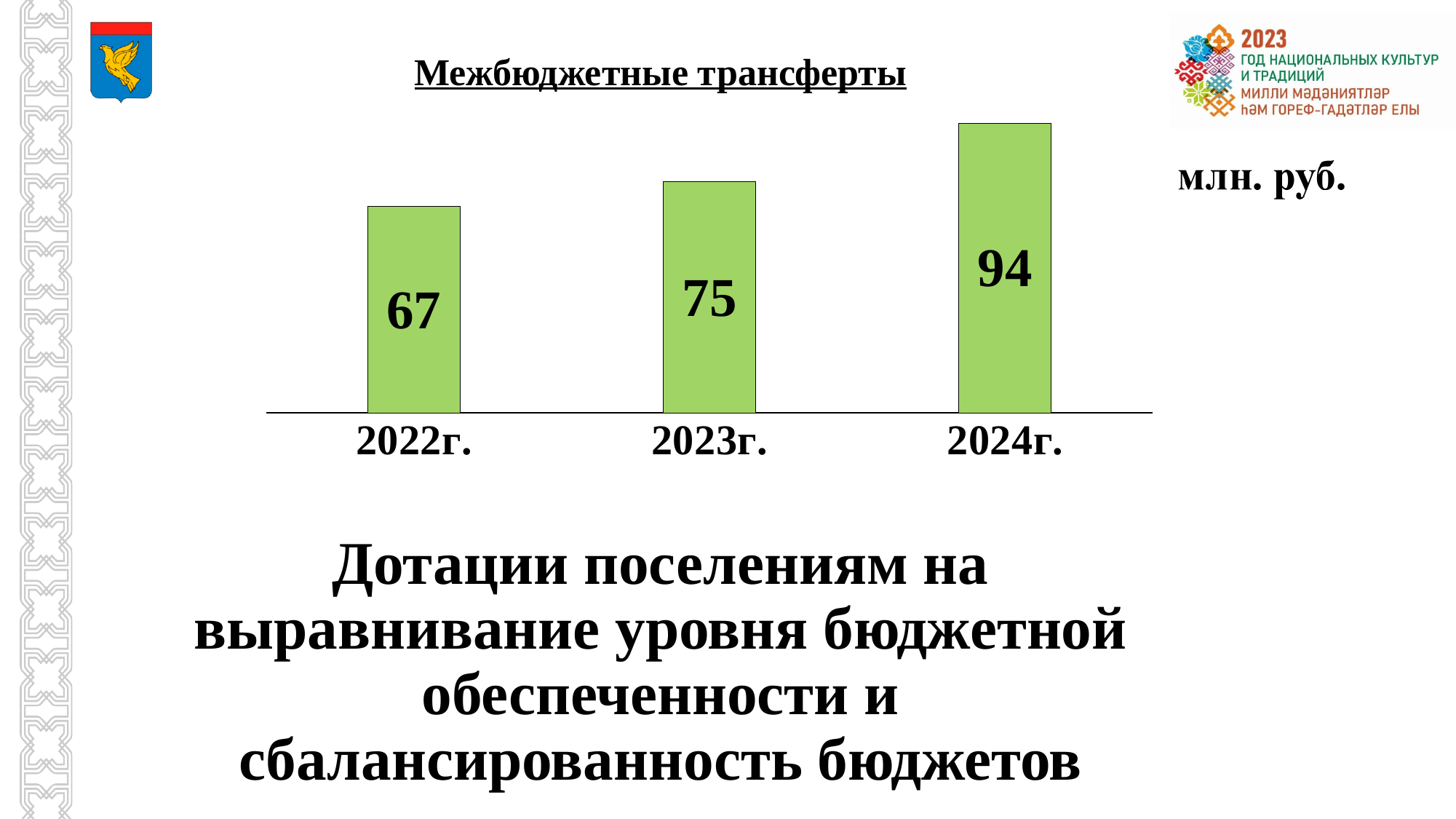
How many years are shown in the Межбюджетные трансферты chart? 3 What is the value for 2022г. in the Межбюджетные трансферты chart? 67 What is the difference between the values for 2023г. and 2022г. in the Межбюджетные трансферты chart? 8 What is the difference between the values for 2024г. and 2022г. in the Межбюджетные трансферты chart? 27 Do the values in the Межбюджетные трансферты chart rise or fall from 2022г. to 2024г.? rise What unit is indicated for the values in the Межбюджетные трансферты chart? млн. руб. Which year has the lowest value in the Межбюджетные трансферты chart? 2022г. Which year has the highest value in the Межбюджетные трансферты chart? 2024г. What is the value for 2023г. in the Межбюджетные трансферты chart? 75 What kind of chart is the Межбюджетные трансферты chart? bar chart Which is larger in the Межбюджетные трансферты chart, the value for 2023г. or 2024г.? 2024г. What is the value for 2024г. in the Межбюджетные трансферты chart? 94